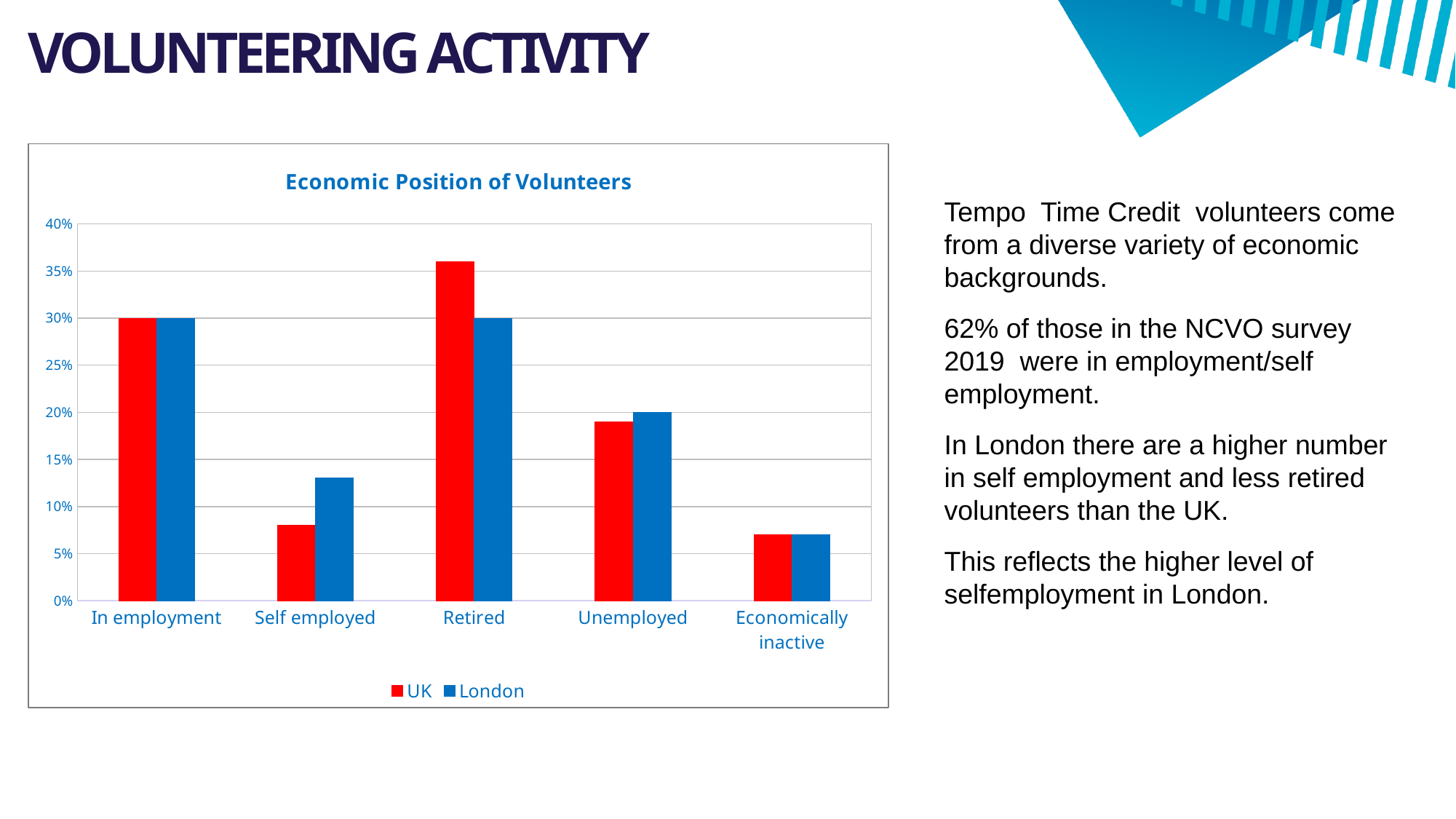
For Self employed, which is larger, the UK value or the London value? London How many series does the chart legend list? 2 Which category has the highest UK value? Retired What is the London value for Retired? 30% Is the UK value for Self employed greater or less than 10%? less Which category has the lowest London value? Economically inactive What is the UK value for In employment? 30% Is the UK value for Retired greater or less than 35%? greater What is the London value for Unemployed? 20% What is the title of the chart? Economic Position of Volunteers How many economic position categories are shown on the x axis? 5 What type of chart is shown on the slide? Bar chart